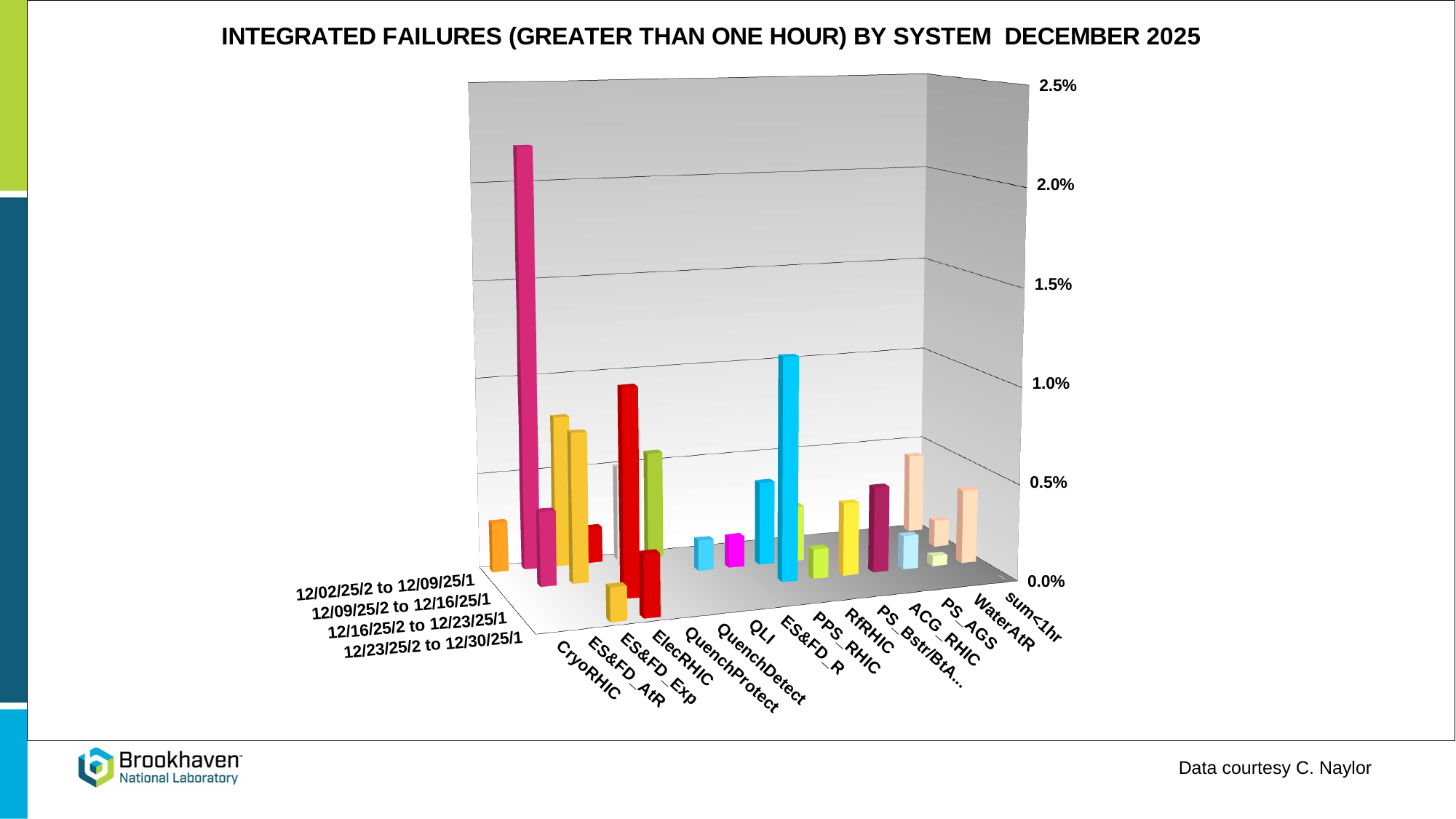
What is the title of the chart? INTEGRATED FAILURES (GREATER THAN ONE HOUR) BY SYSTEM DECEMBER 2025 Which category is listed first on the x axis of the chart? CryoRHIC How many system categories are listed along the x axis of the chart? 15 Which time period is listed first (at the back) on the depth axis of the chart? 12/02/25/2 to 12/09/25/1 What is the highest value shown on the vertical axis of the chart? 2.5% Which time period is listed last (at the front) on the depth axis of the chart? 12/23/25/2 to 12/30/25/1 Which category is listed last on the x axis of the chart? sum<1hr What kind of chart is shown on the slide? bar chart How many weekly time periods (series) are plotted along the depth axis of the chart? 4 Is the tallest bar in the chart greater or less than 1.5%? greater Is the tallest bar in the chart greater or less than 2.5%? less